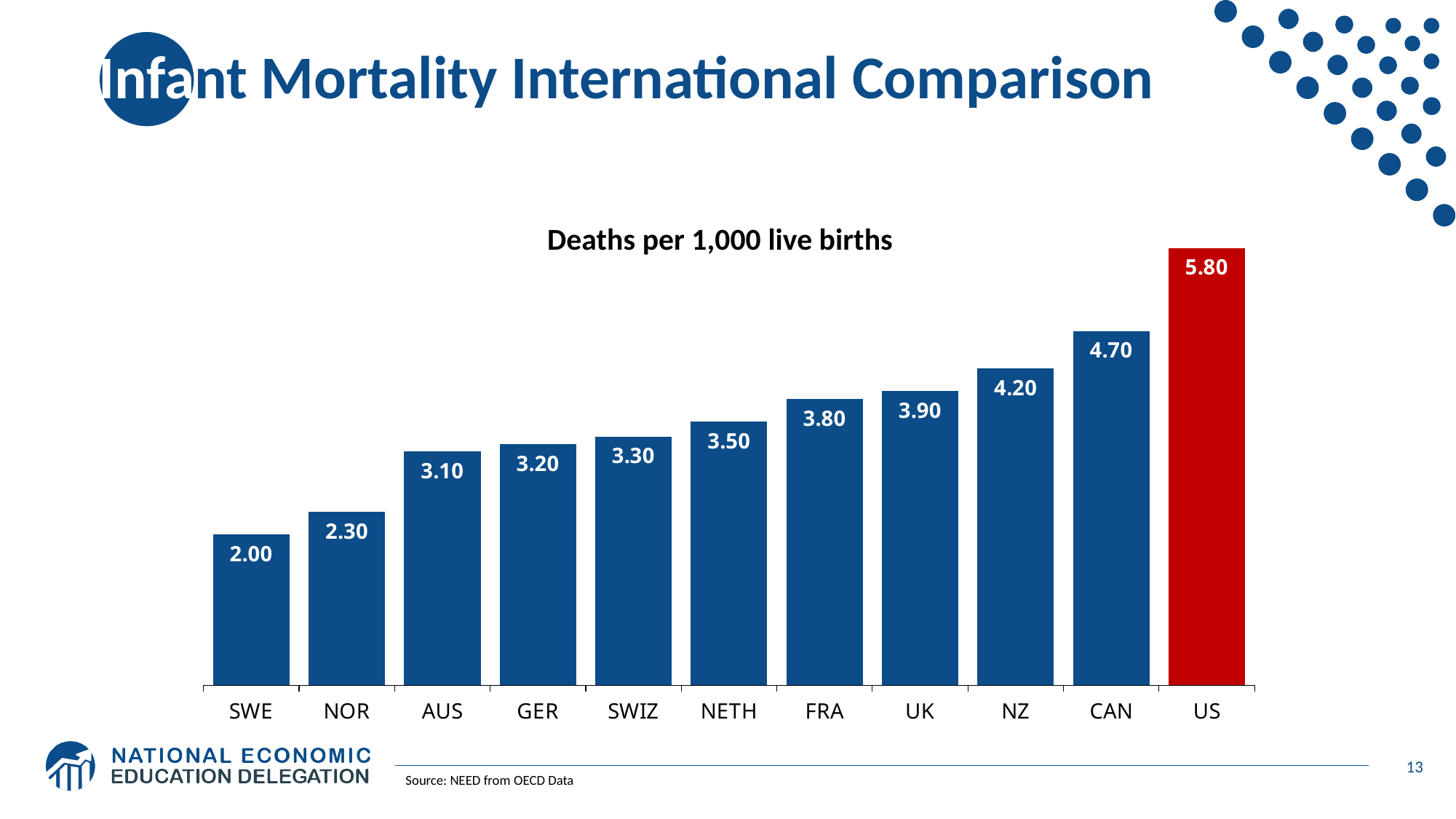
What is the value for Canada (CAN) in the chart? 4.70 What is the difference between the US value and the Sweden (SWE) value? 3.80 Which country has the lowest infant mortality rate in the chart? SWE Which country has the highest infant mortality rate in the chart? US What is the value for Germany (GER) in the chart? 3.20 Which has a higher value, France (FRA) or the Netherlands (NETH)? FRA What is the difference between the Canada (CAN) value and the New Zealand (NZ) value? 0.50 How many countries are shown in the chart? 11 What kind of chart is shown on the slide? Bar chart Which bar is coloured red rather than blue? US Do the values rise or fall from left to right across the chart? Rise What is the value for the US in the chart? 5.80